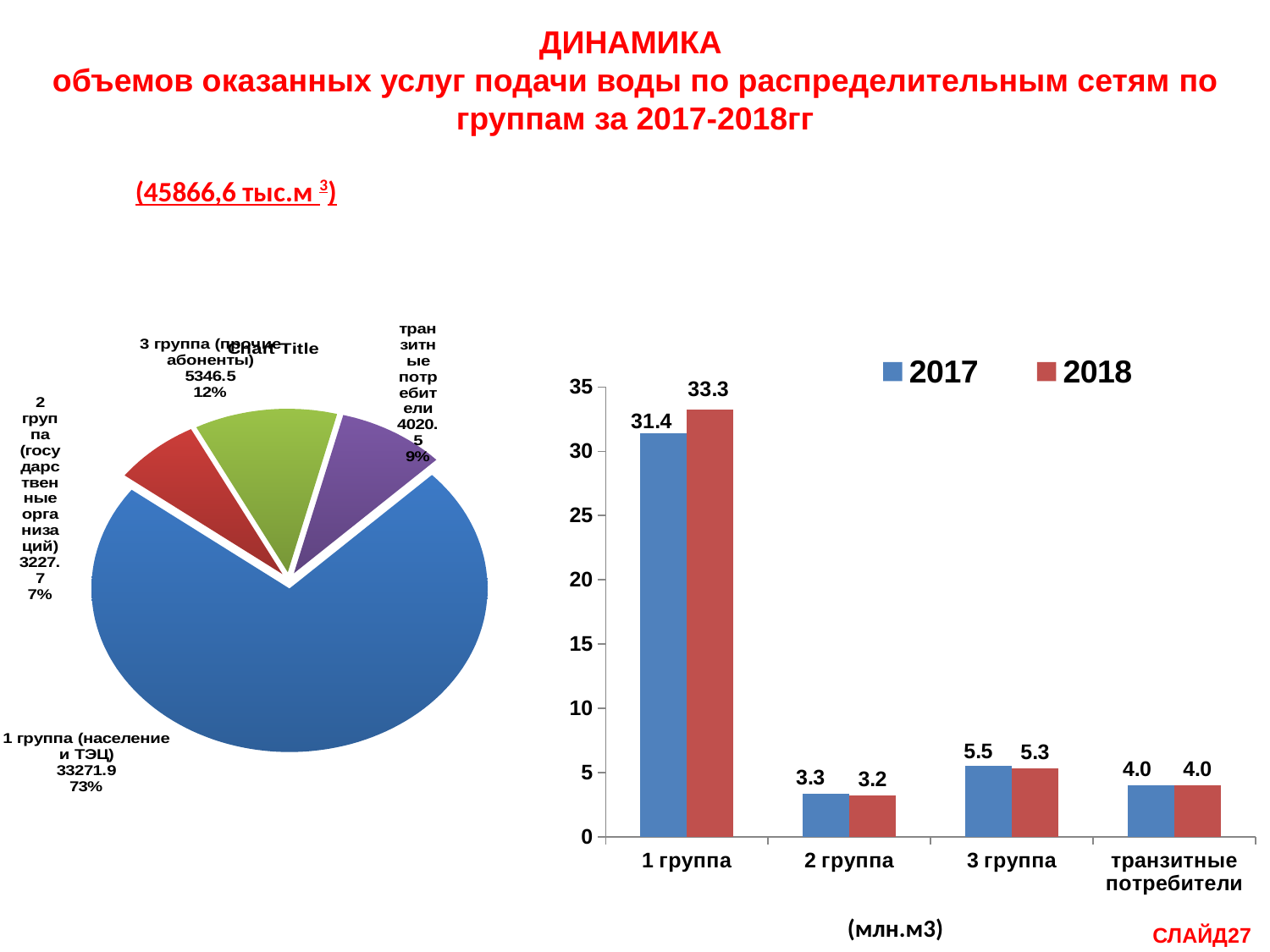
In the bar chart on the right, which category has the lowest value in 2018? 2 группа In the pie chart on the left, what share does 1 группа (население и ТЭЦ) have? 73% What kind of chart is on the left side of the slide? Pie chart In the bar chart on the right, how many categories are shown on the x axis? 4 In the bar chart on the right, what is the value for 2 группа in 2018? 3.2 In the bar chart on the right, is the 2017 value for 3 группа larger or smaller than the 2018 value? larger In the bar chart on the right, what is the value for 1 группа in 2018? 33.3 In the bar chart on the right, which category has the highest value in 2017? 1 группа In the bar chart on the right, what is the difference between the 2018 and 2017 values for 1 группа? 1.9 In the bar chart on the right, what is the value for 3 группа in 2017? 5.5 In the pie chart on the left, what is the value shown for 3 группа (прочие абоненты)? 5346.5 In the bar chart on the right, how many series does the legend list? 2